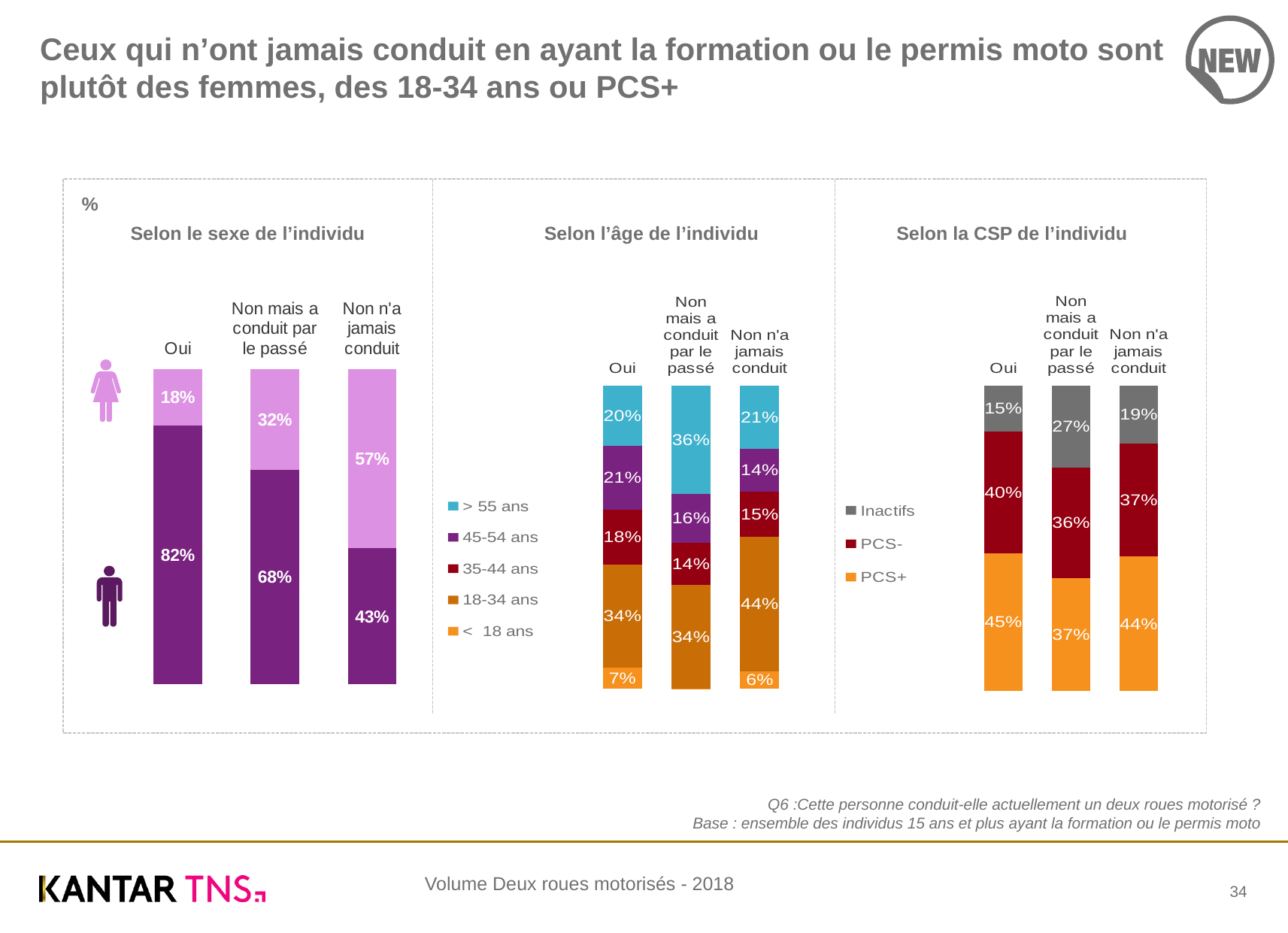
In the chart 'Selon la CSP de l'individu', what is the value for 'PCS+' in the 'Oui' bar? 45% In the chart 'Selon la CSP de l'individu', is the 'PCS-' share larger for 'Oui' or for 'Non n'a jamais conduit'? Oui In the chart 'Selon la CSP de l'individu', how many bars are shown? 3 In the chart 'Selon l'âge de l'individu', what is the value for '> 55 ans' in the 'Non mais a conduit par le passé' bar? 36% In the chart 'Selon le sexe de l'individu', what is the share of men for 'Oui'? 82% In the chart 'Selon l'âge de l'individu', which age group has the largest share in the 'Oui' bar? 18-34 ans In the chart 'Selon l'âge de l'individu', what is the value for '18-34 ans' in the 'Non n'a jamais conduit' bar? 44% What type of chart is used in the 'Selon le sexe de l'individu' panel? Stacked bar chart In the chart 'Selon l'âge de l'individu', how many series does the legend list? 5 In the chart 'Selon le sexe de l'individu', what is the difference between the men's share for 'Oui' and for 'Non n'a jamais conduit'? 39 percentage points In the chart 'Selon le sexe de l'individu', what is the share of women for 'Non n'a jamais conduit'? 57% In the chart 'Selon la CSP de l'individu', what is the value for 'Inactifs' in the 'Non mais a conduit par le passé' bar? 27%